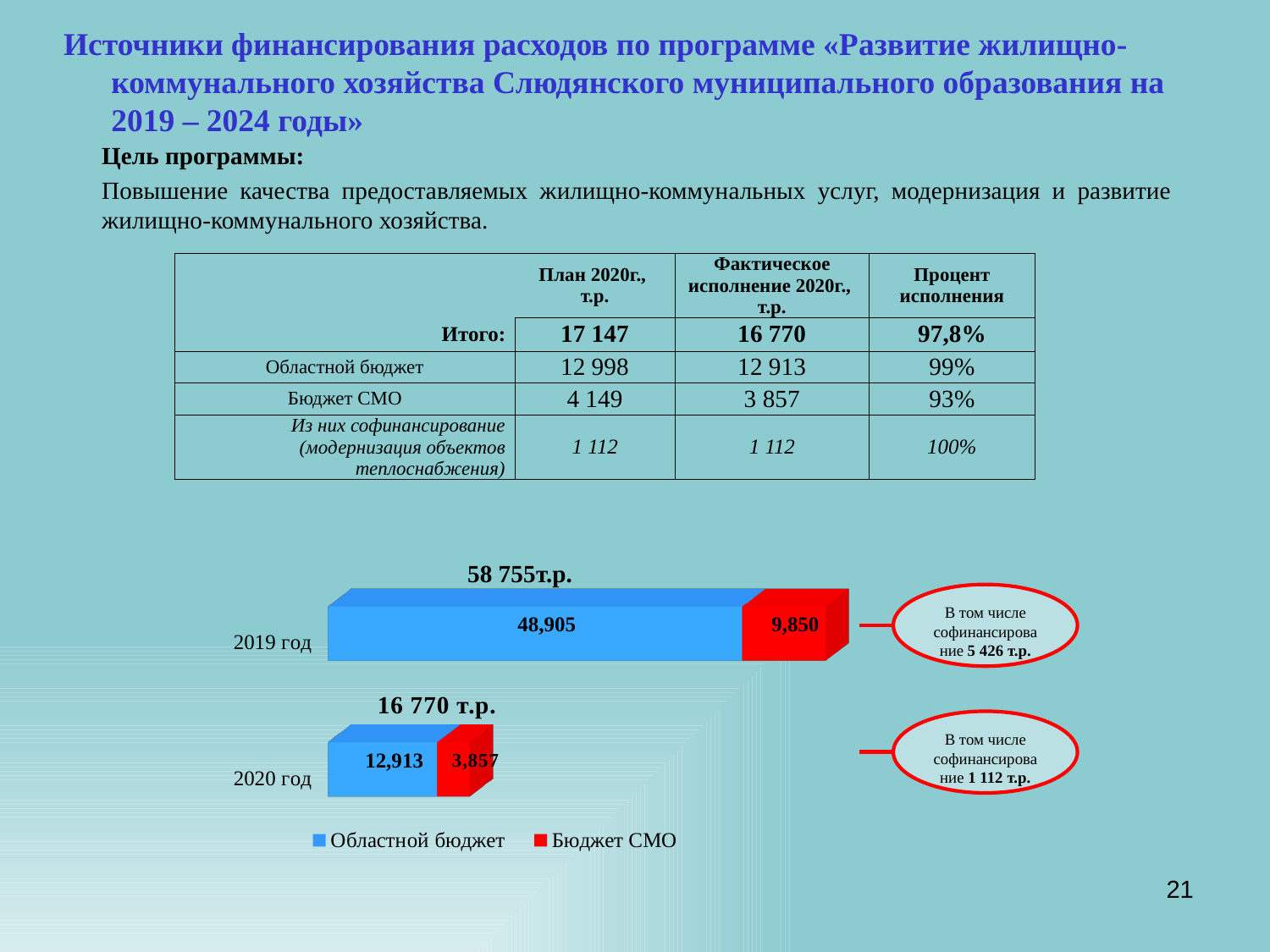
What is the total of the stacked bar for 2020 год? 16 770 т.р. How many categories (years) are plotted in the chart? 2 What is the difference between the Бюджет СМО values for 2019 год and 2020 год? 5,993 What is the total of the stacked bar for 2019 год? 58 755т.р. What is the value of Бюджет СМО for 2020 год in the chart? 3,857 What is the value of Областной бюджет for 2020 год in the chart? 12,913 Which colour represents Бюджет СМО in the chart legend? red How many series does the chart legend list? 2 Which year has the larger Областной бюджет value in the chart? 2019 год What is the value of Бюджет СМО for 2019 год in the chart? 9,850 What type of chart is shown on the slide? bar chart What is the value of Областной бюджет for 2019 год in the chart? 48,905